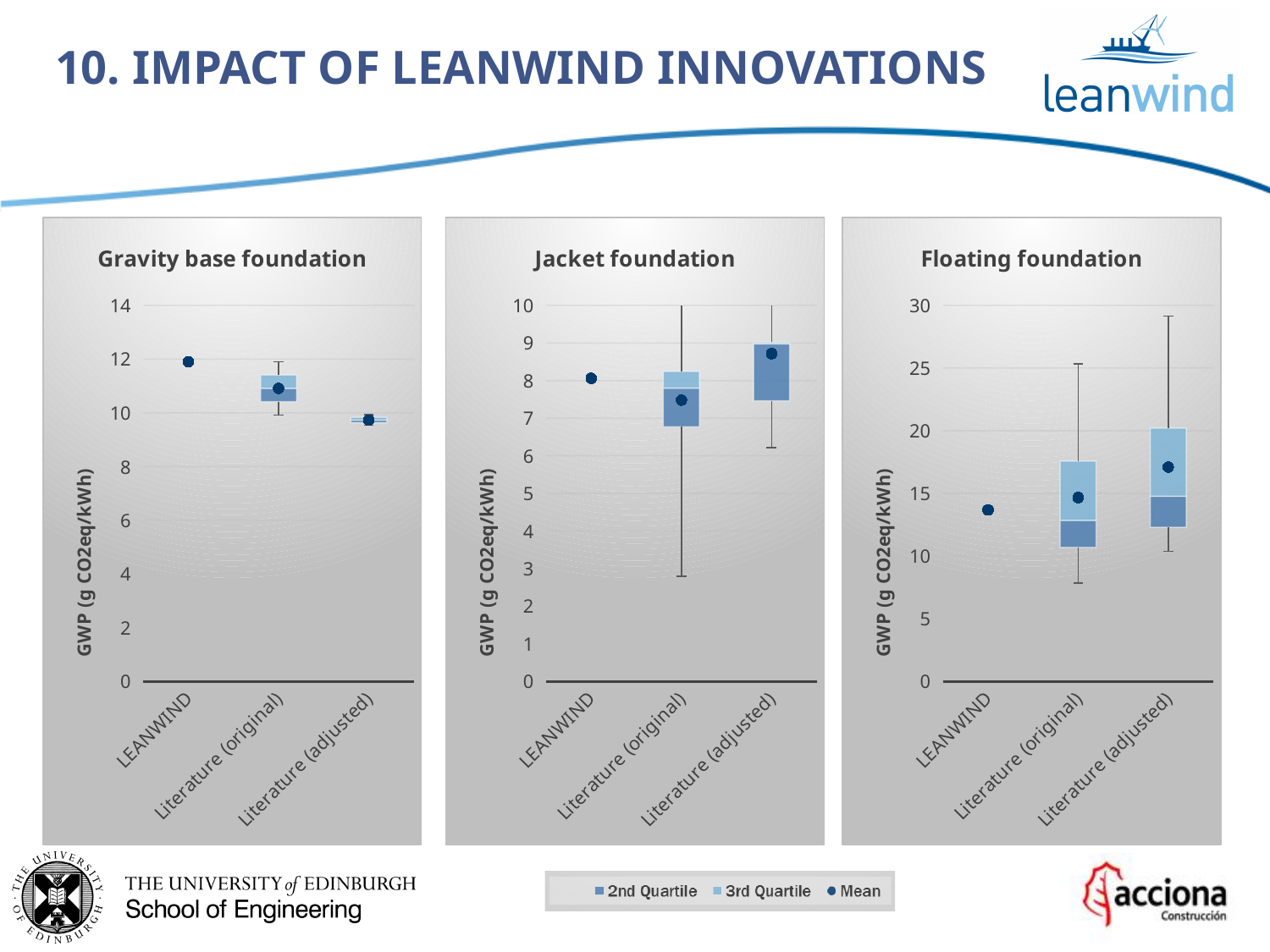
In the Jacket foundation chart, which category has the highest mean? Literature (adjusted) What are the three entries in the legend? 2nd Quartile, 3rd Quartile, Mean In the Gravity base foundation chart, is the mean for LEANWIND greater or less than 10? greater In the Gravity base foundation chart, which category has the lowest mean? Literature (adjusted) How many entries does the shared legend list? 3 In the Gravity base foundation chart, which category has the highest mean? LEANWIND How many charts are shown on the slide? 3 What is the y-axis label on the Jacket foundation chart? GWP (g CO2eq/kWh) In the Gravity base foundation chart, how many categories are on the x axis? 3 In the Floating foundation chart, which has the larger mean, LEANWIND or Literature (adjusted)? Literature (adjusted) In the Floating foundation chart, is the mean for Literature (adjusted) greater or less than 15? greater In the Jacket foundation chart, is the mean for Literature (original) greater or less than 8? less